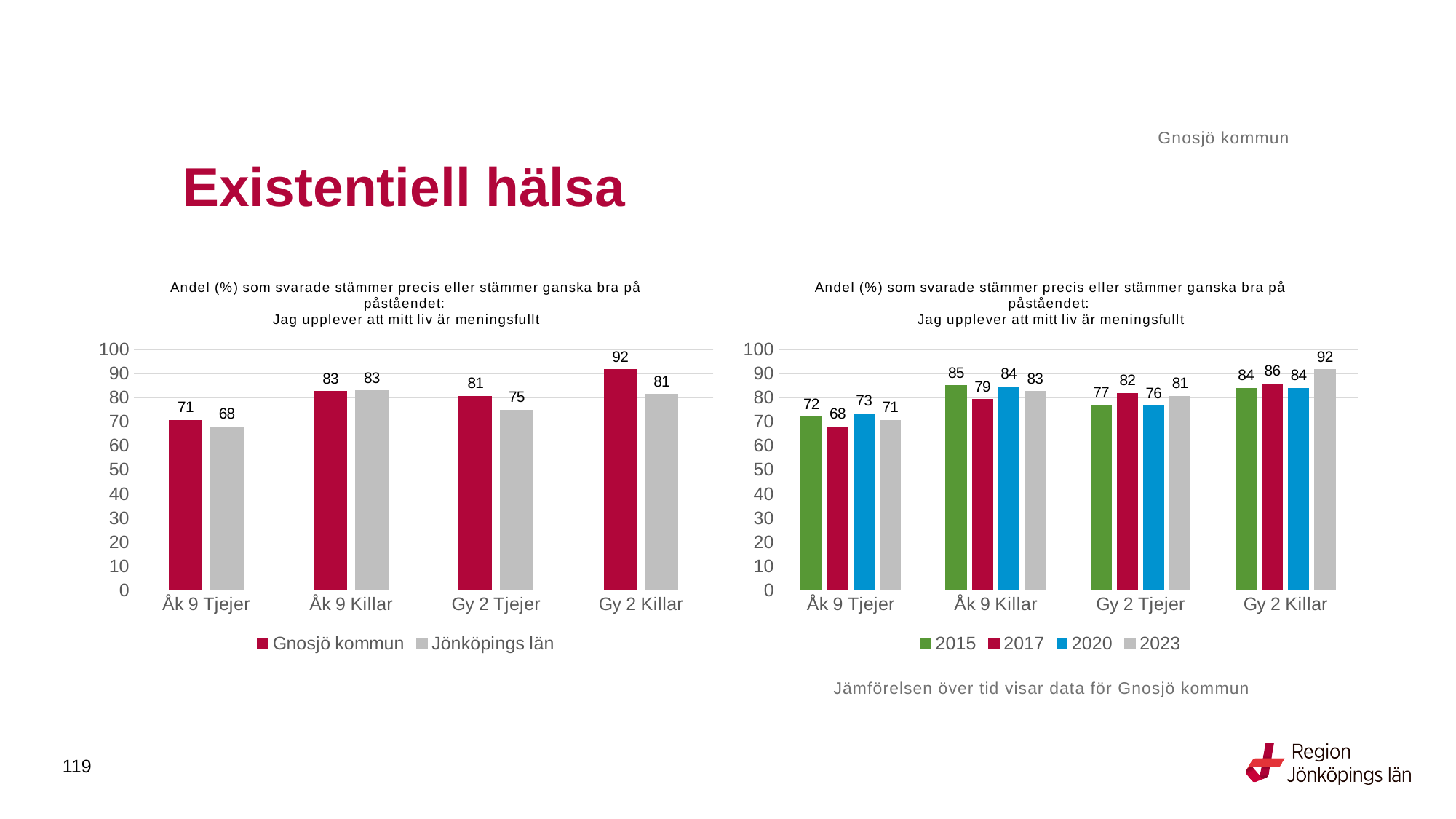
In the left chart, which category has the lowest value for Jönköpings län? Åk 9 Tjejer In the right chart, is the value for 2015 for Åk 9 Tjejer larger or smaller than the value for 2017 for Åk 9 Tjejer? larger In the right chart, what is the value for 2023 for Gy 2 Killar? 92 In the left chart, what is the value for Jönköpings län for Gy 2 Tjejer? 75 In the right chart, what is the value for 2017 for Åk 9 Killar? 79 In the right chart, which year has the highest value for Gy 2 Tjejer? 2017 In the left chart, what is the value for Gnosjö kommun for Gy 2 Killar? 92 In the right chart, how many series does the legend list? 4 In the left chart, what is the difference between Gnosjö kommun and Jönköpings län for Gy 2 Killar? 11 In the right chart, how many categories are shown on the x axis? 4 What kind of chart is the left chart? bar chart In the left chart, how many series does the legend list? 2